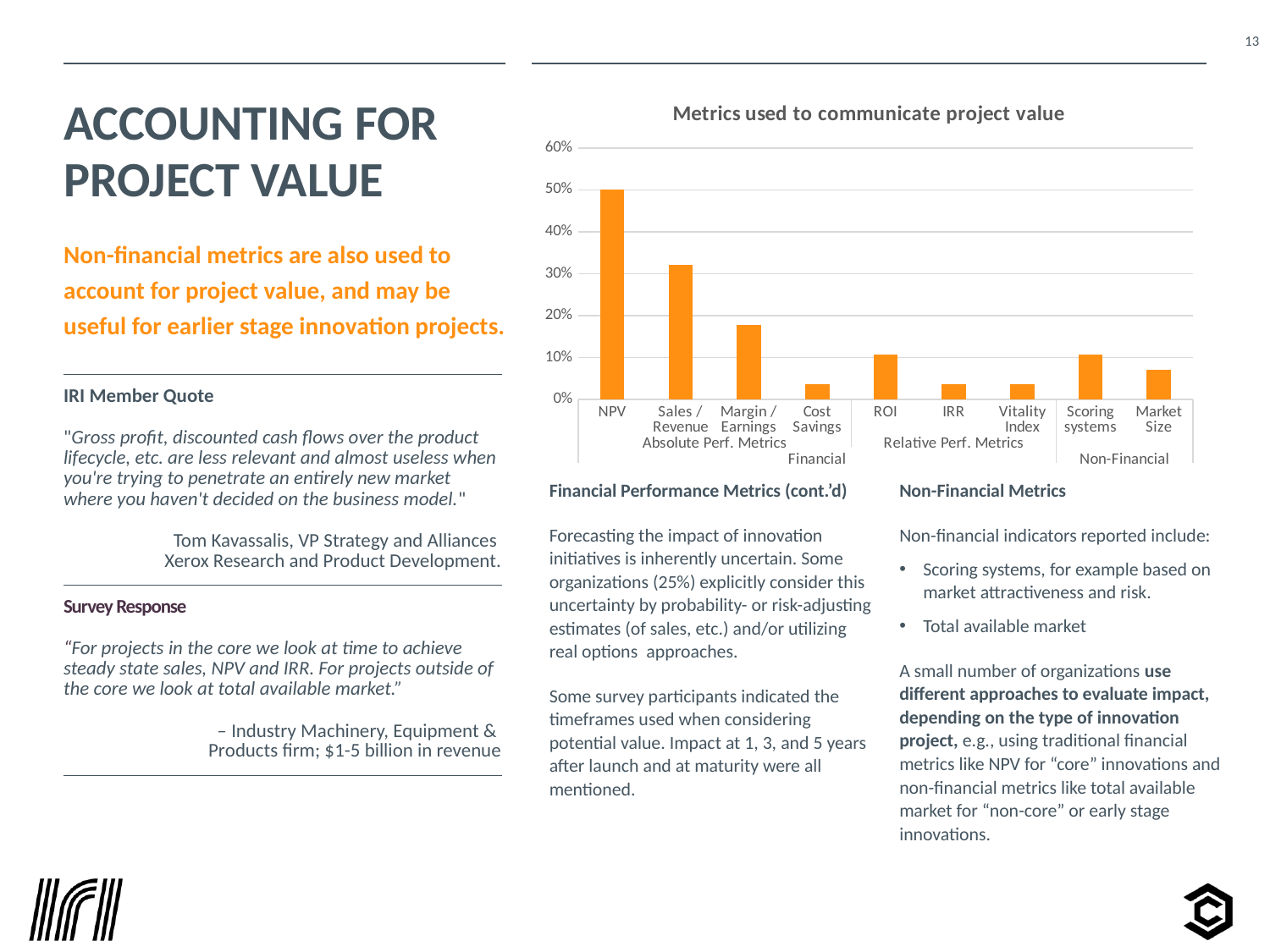
Is the value for Cost Savings greater or less than 10%? less Which is larger, the value for ROI or the value for IRR? ROI Which metric has the highest value in the chart? NPV Is the value for Sales / Revenue greater or less than 30%? greater Which group of metrics on the x axis contains NPV, Sales / Revenue, Margin / Earnings and Cost Savings? Absolute Perf. Metrics Is the value for NPV greater or less than 40%? greater What is the title of the chart? Metrics used to communicate project value What kind of chart is shown on the slide? bar chart Which is larger, the value for Scoring systems or the value for Market Size? Scoring systems How many metrics (bars) are plotted in the chart? 9